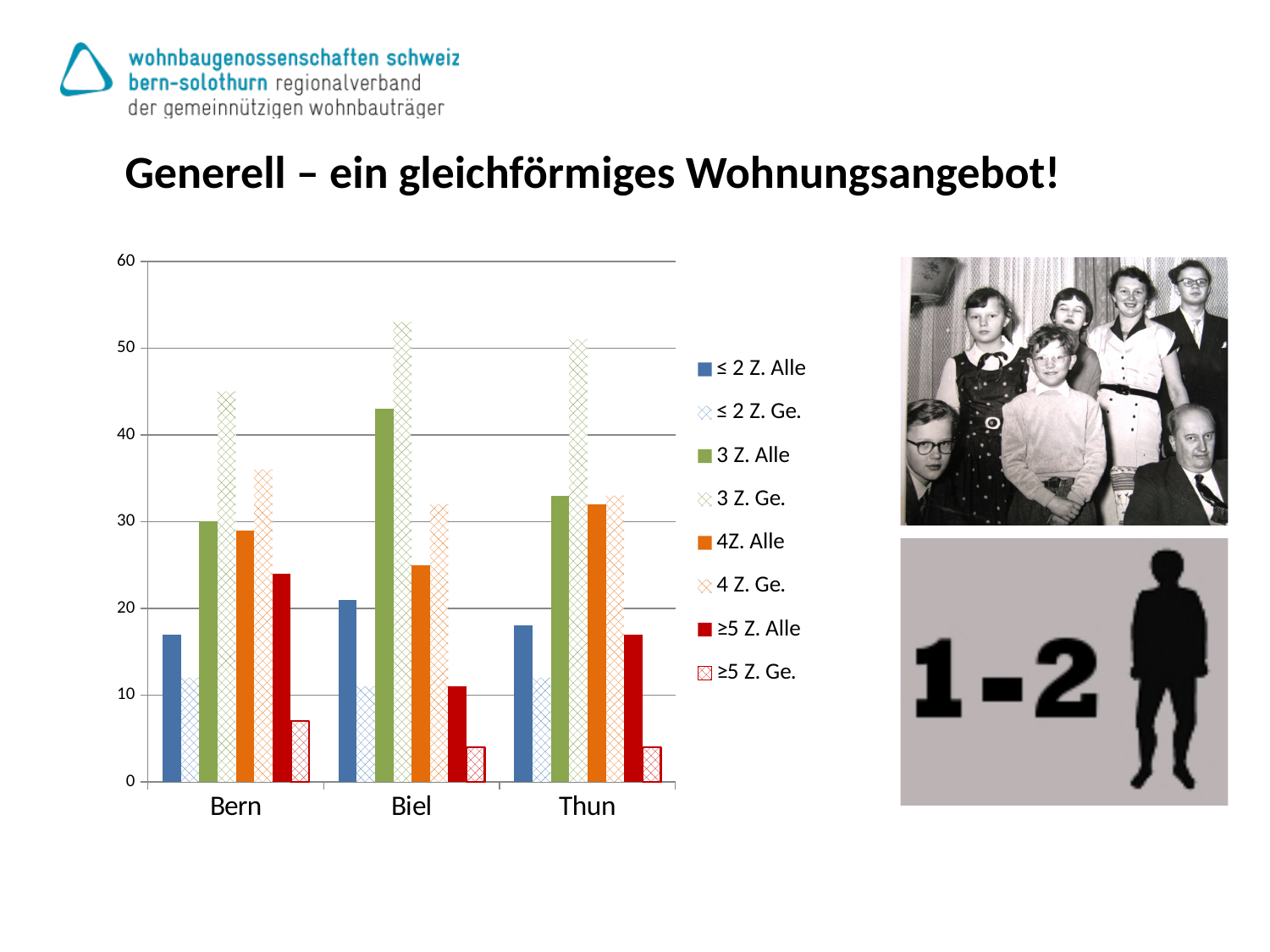
Is the value for 3 Z. Ge. in Biel greater or less than 50? greater Is the value for ≥5 Z. Ge. in Thun greater or less than 10? less Which series has the lowest value for Bern? ≥5 Z. Ge. Is the value for 3 Z. Ge. in Bern greater or less than 40? greater Which series has the highest value for Biel? 3 Z. Ge. How many cities are shown on the x axis of the chart? 3 How many series does the chart's legend list? 8 Which is larger, the 3 Z. Alle value for Biel or for Bern? Biel What kind of chart is shown on the slide? bar chart What are the three categories shown on the x axis of the chart? Bern, Biel, Thun Which city has the highest value for ≤ 2 Z. Alle? Biel Which is larger, the ≥5 Z. Alle value for Bern or for Biel? Bern